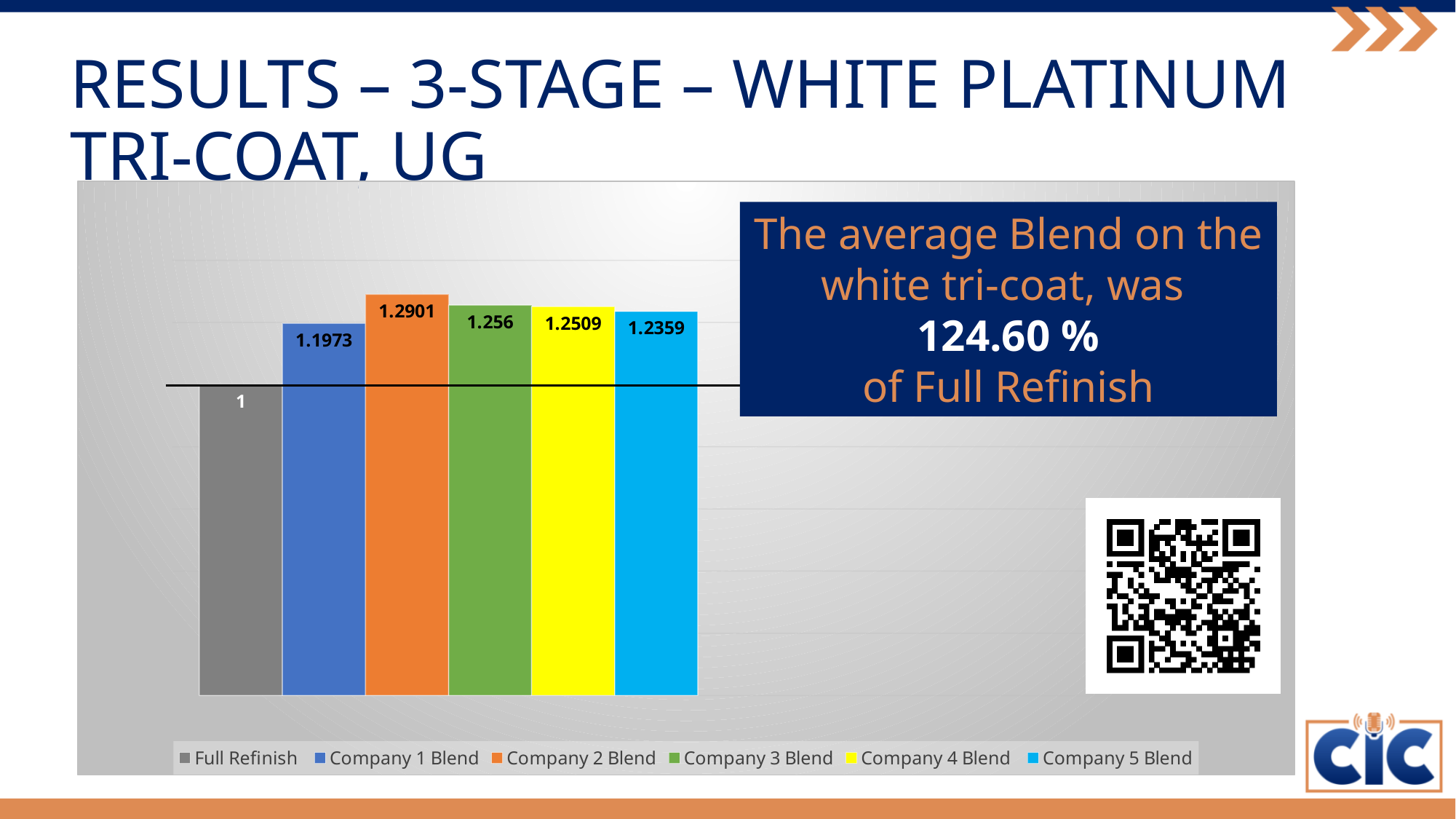
What is the value for Company 5 Blend? 1.2359 Which is larger, the value for Company 3 Blend or Company 5 Blend? Company 3 Blend What is the value for Company 2 Blend? 1.2901 How many series does the legend list? 6 What is the value for Company 1 Blend? 1.1973 Which series has the lowest value? Full Refinish What kind of chart is shown on the slide? bar chart How many bars are plotted on the chart? 6 Which series has the highest value? Company 2 Blend What is the value for Full Refinish? 1 What colour is the bar for Company 4 Blend? yellow What is the difference between the values for Company 2 Blend and Company 1 Blend? 0.0928